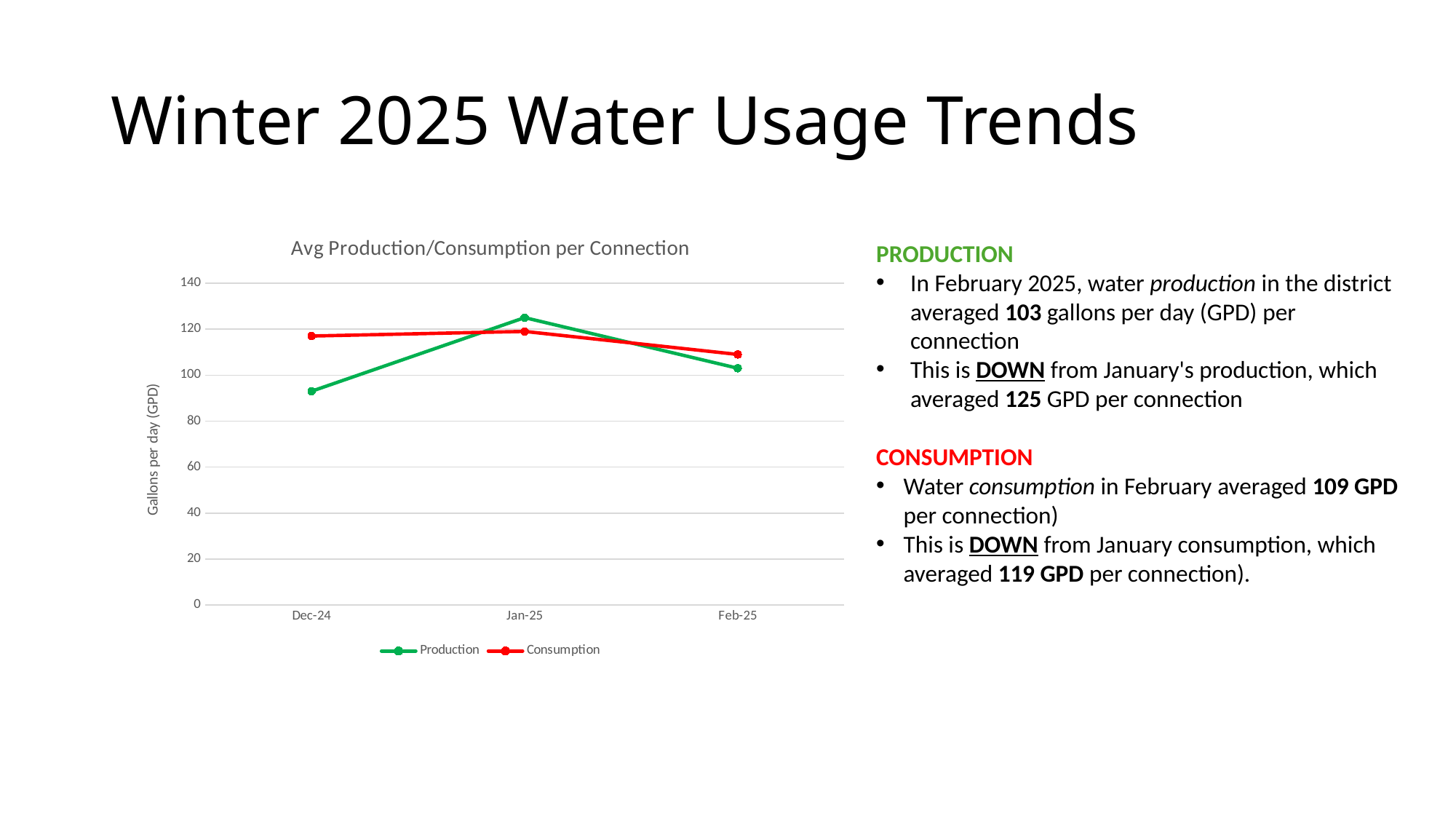
By how much did Production fall from Jan-25 to Feb-25? 22 How many series does the chart legend list? 2 Is the Production value for Dec-24 greater or less than 100? less In which month is Production lowest? Dec-24 What is the Production value for Feb-25? 103 Which is larger in Jan-25, Production or Consumption? Production How many months are plotted on the x axis of the chart? 3 What kind of chart is shown on the slide? line chart What is the Consumption value for Feb-25? 109 What is the Production value for Jan-25? 125 What is the Consumption value for Jan-25? 119 In which month is Production highest? Jan-25